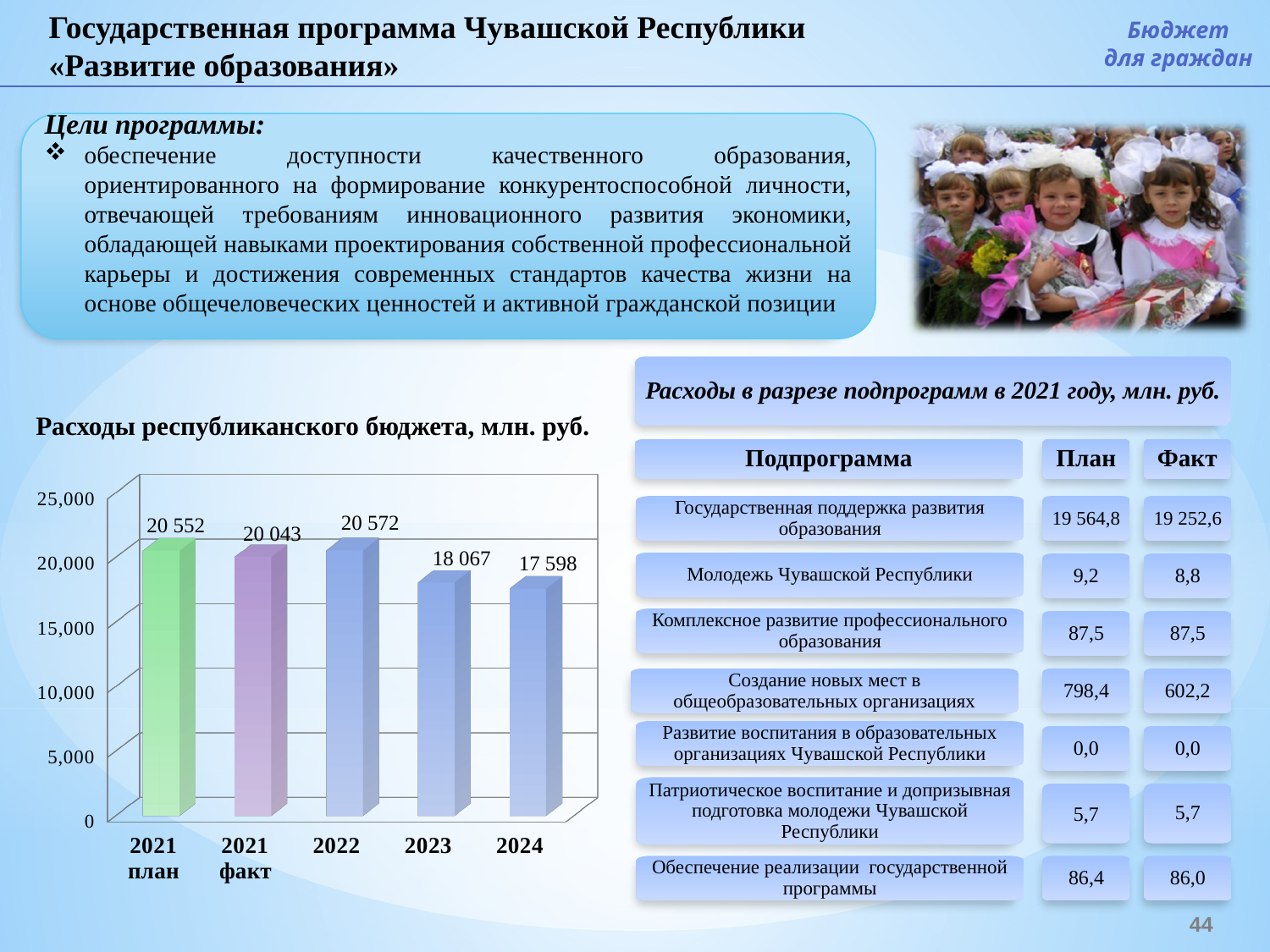
What is the difference between the 2022 and 2023 values? 2 505 What is the value for 2021 план in the chart «Расходы республиканского бюджета, млн. руб.»? 20 552 Is the value for 2023 greater or less than 20,000? less What is the value shown for 2023 in the chart? 18 067 Which category has the lowest value in the chart? 2024 What is the difference between the 2021 план and 2021 факт values? 509 How many bars are shown in the chart? 5 What kind of chart is used to show the republican budget expenditures? bar chart Do the values rise or fall from 2022 to 2024? fall What is the value for 2021 факт in the chart? 20 043 Which is larger, the value for 2023 or the value for 2024? 2023 What is the value shown for 2024 in the chart? 17 598